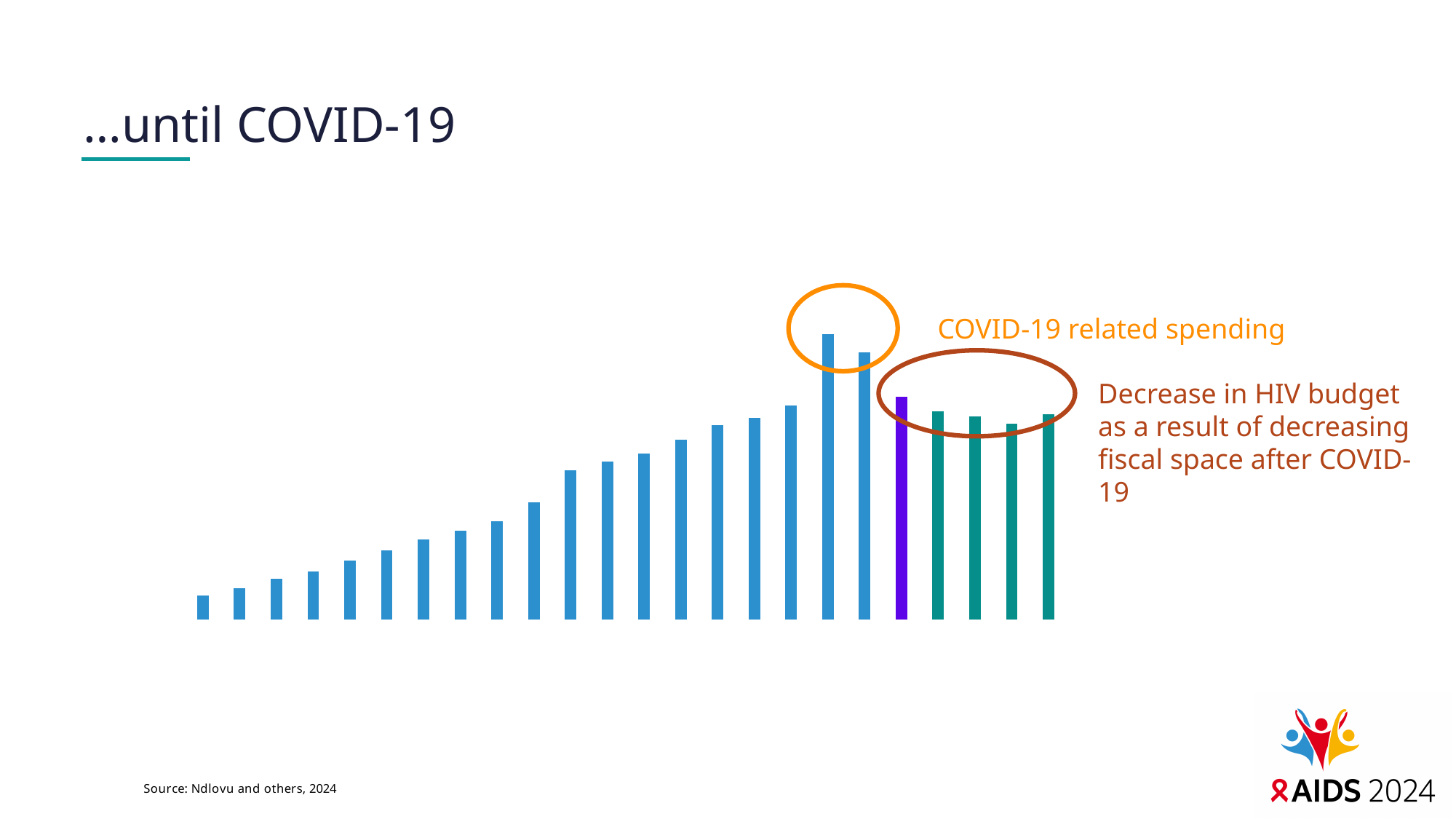
Where is the tallest bar in the chart located? inside the orange circle How many purple bars are in the chart? 1 Do the bars after the orange-circled peak rise or fall compared with the peak? fall Do the blue bars rise or fall from left to right? rise What does the orange circle on the chart label? COVID-19 related spending Which is taller, the purple bar or the first teal bar to its right? the purple bar What kind of chart is shown on the slide? bar chart How many teal (green) bars are in the chart? 4 Which bar is the shortest in the chart? the leftmost bar What colour are the bars inside the brown circle? purple and teal